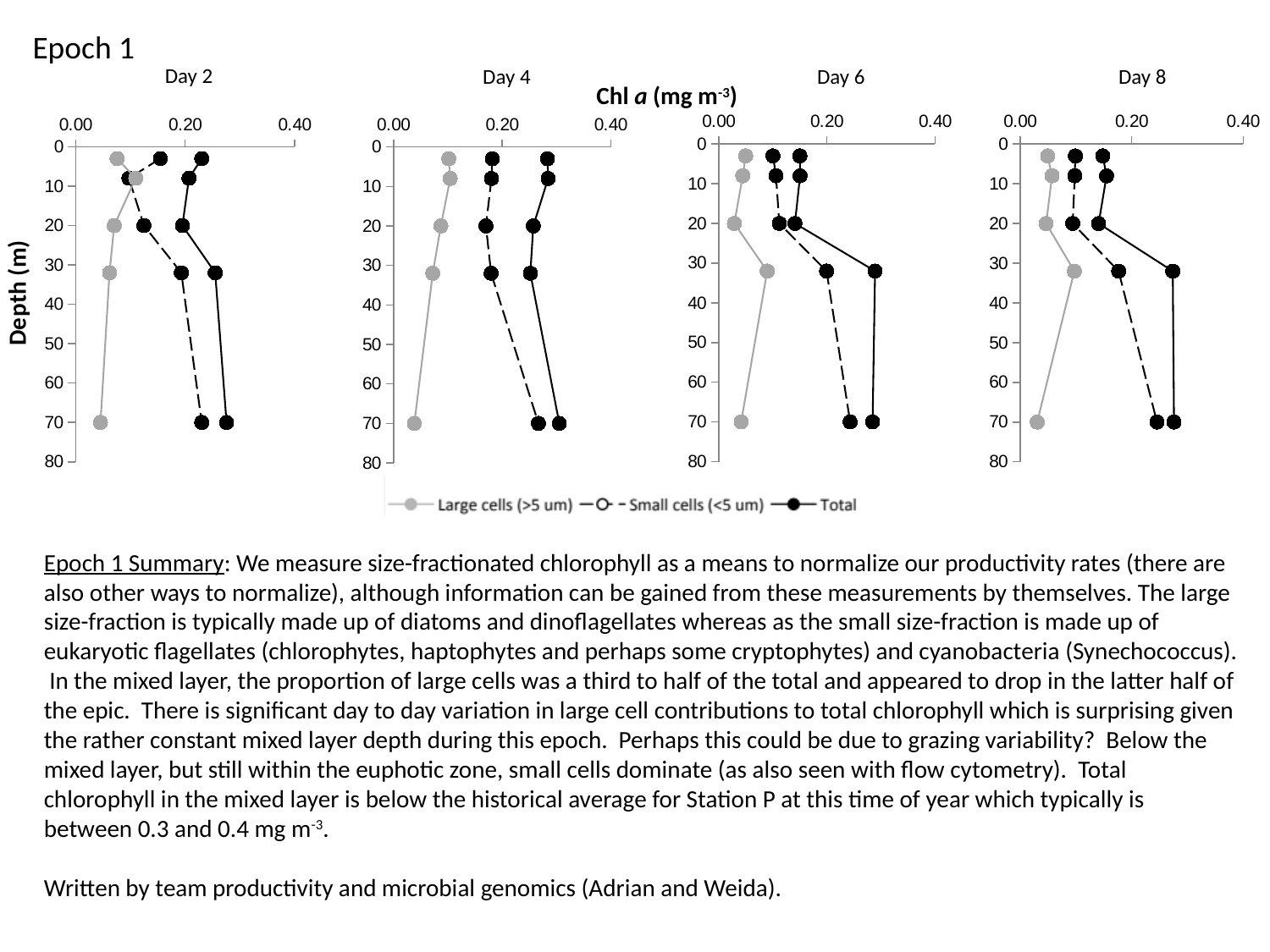
How many charts are shown on the slide? 4 In the Day 6 chart, is the Total value at 3 m depth greater or less than 0.20? less How many depth points are plotted for the Large cells (>5 um) series in the Day 4 chart? 5 In the Day 2 chart, is the Large cells (>5 um) value at 70 m depth greater or less than 0.20? less What kind of chart is the Day 2 chart? line chart In the Day 8 chart, is the Total value at 32 m depth greater or less than 0.20? greater What is the title of the y axis on the Day 2 chart? Depth (m) How many series does the legend list for the charts? 3 What is the shared x-axis title above the charts? Chl a (mg m-3) In the Day 6 chart, at 32 m depth, which series has the larger value: Total or Large cells (>5 um)? Total